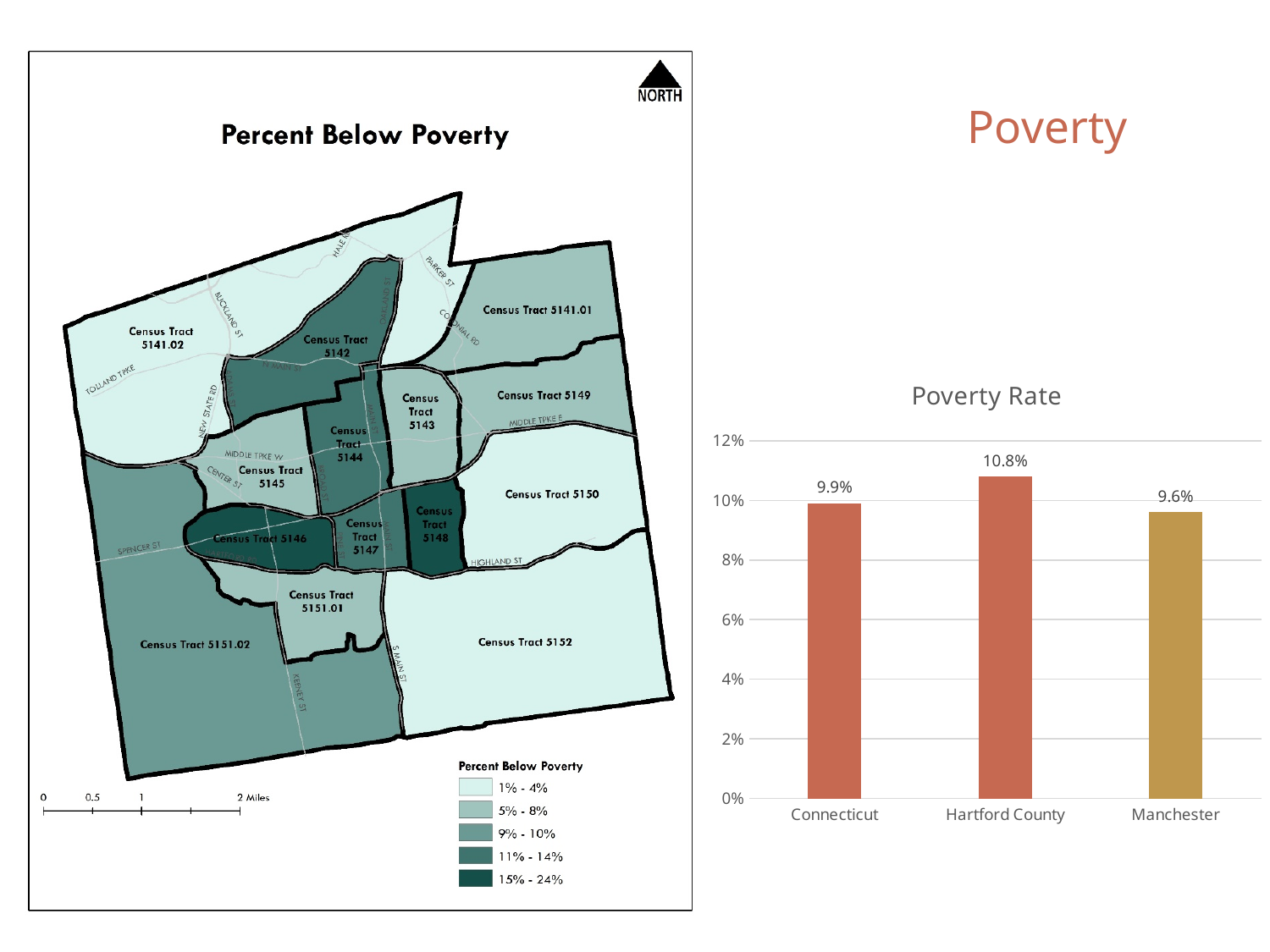
In the Poverty Rate chart, what is the poverty rate for Connecticut? 9.9% In the Poverty Rate chart, what is the difference between the poverty rates of Connecticut and Manchester? 0.3% In the Poverty Rate chart, is the value for Manchester greater or less than 10%? less In the Poverty Rate chart, which bar is a different colour from the others? Manchester How many categories are shown in the Poverty Rate chart? 3 In the Poverty Rate chart, which category has the lowest poverty rate? Manchester What kind of chart is the Poverty Rate chart? bar chart In the Poverty Rate chart, which category has the highest poverty rate? Hartford County In the Poverty Rate chart, what is the poverty rate for Hartford County? 10.8% In the Poverty Rate chart, which is larger, the poverty rate for Connecticut or for Hartford County? Hartford County In the Poverty Rate chart, what is the difference between the poverty rates of Hartford County and Manchester? 1.2% In the Poverty Rate chart, what is the poverty rate for Manchester? 9.6%